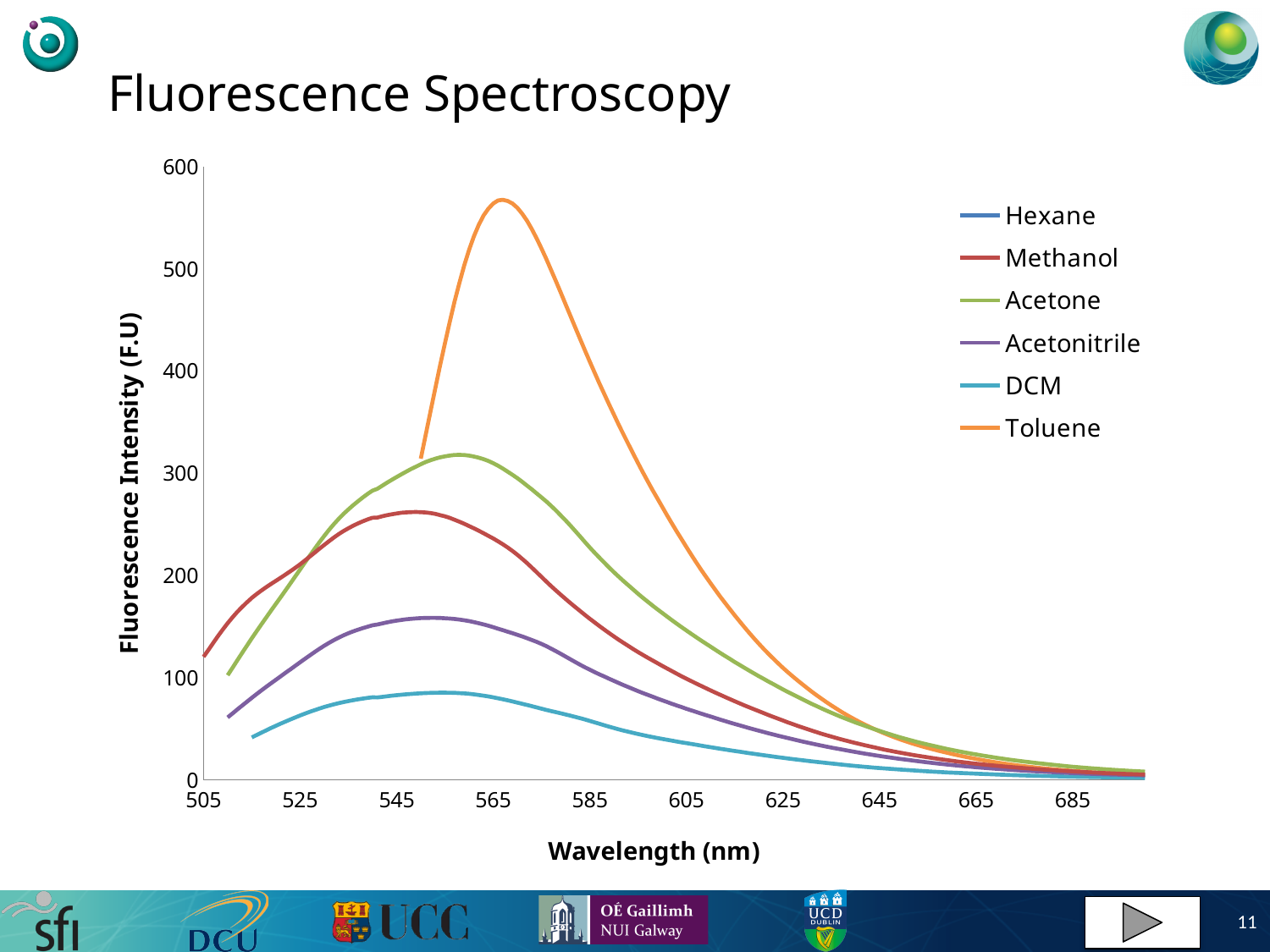
Which reaches a higher peak intensity, Acetone or Methanol? Acetone What kind of chart is shown on the slide? line chart How many series does the legend list? 6 Is the peak value for DCM greater or less than 100? less Do the intensity values rise or fall as wavelength increases beyond 585 nm? fall Which solvent reaches the highest fluorescence intensity? Toluene Is the peak value for Toluene greater or less than 500? greater What is the title of the x axis? Wavelength (nm) Is the peak value for Acetone greater or less than 300? greater At 605 nm, which has the higher intensity, Methanol or Acetonitrile? Methanol